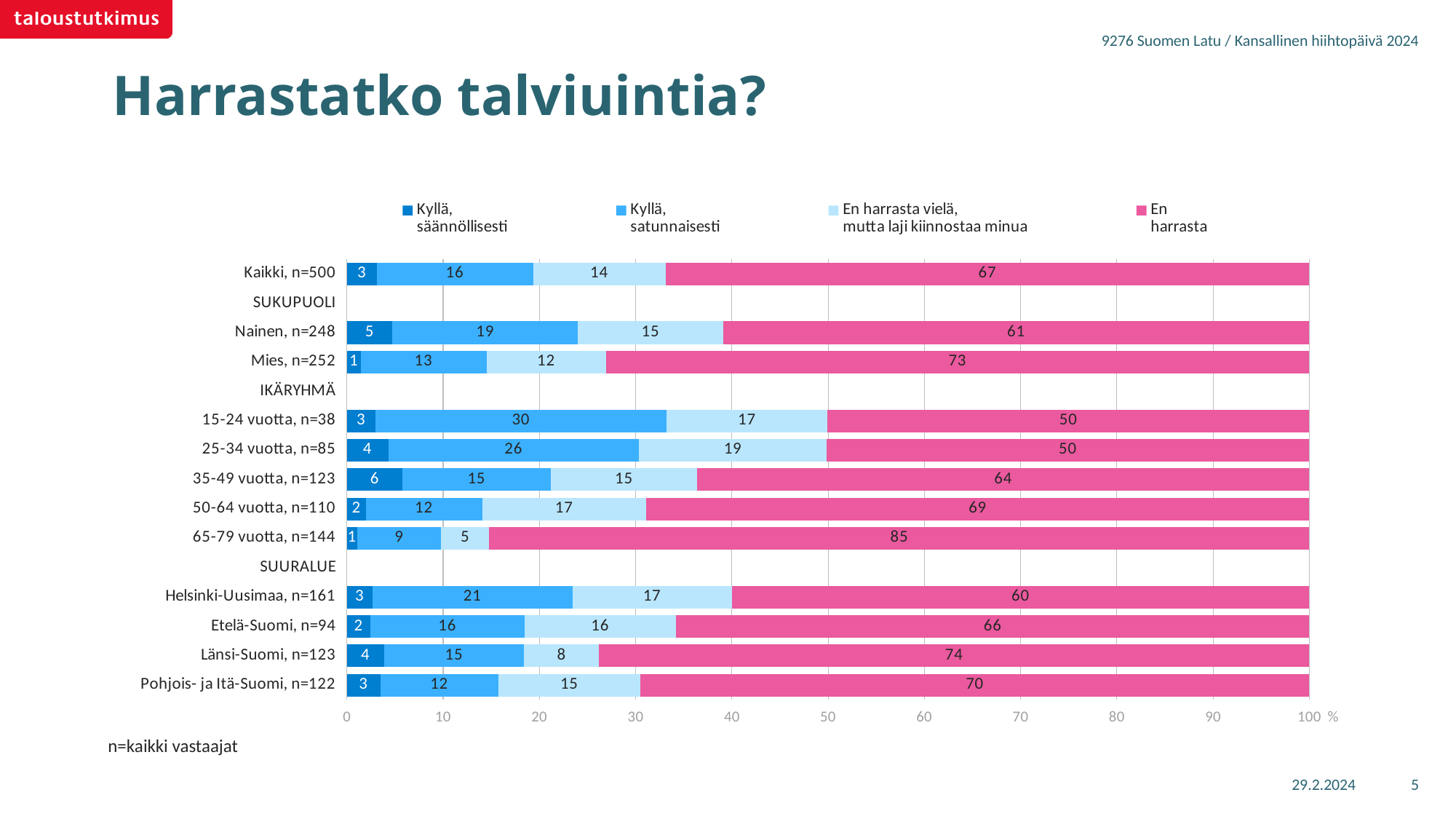
What is the difference between the 'En harrasta' values for Mies, n=252 and Nainen, n=248? 12 Which group has the highest 'En harrasta' value? 65-79 vuotta, n=144 Which group has the lowest 'Kyllä, satunnaisesti' value? 65-79 vuotta, n=144 What is the 'En harrasta vielä, mutta laji kiinnostaa minua' value for Länsi-Suomi, n=123? 8 What is the 'En harrasta' value for Kaikki, n=500? 67 How many groups have bars plotted in the chart? 12 What type of chart is shown on the slide? stacked bar chart What is the 'Kyllä, satunnaisesti' value for 15-24 vuotta, n=38? 30 Which has a larger 'Kyllä, säännöllisesti' value, 35-49 vuotta, n=123 or 50-64 vuotta, n=110? 35-49 vuotta, n=123 How many series does the legend list? 4 What is the total of the stacked bar for Kaikki, n=500? 100 What is the title of the slide? Harrastatko talviuintia?